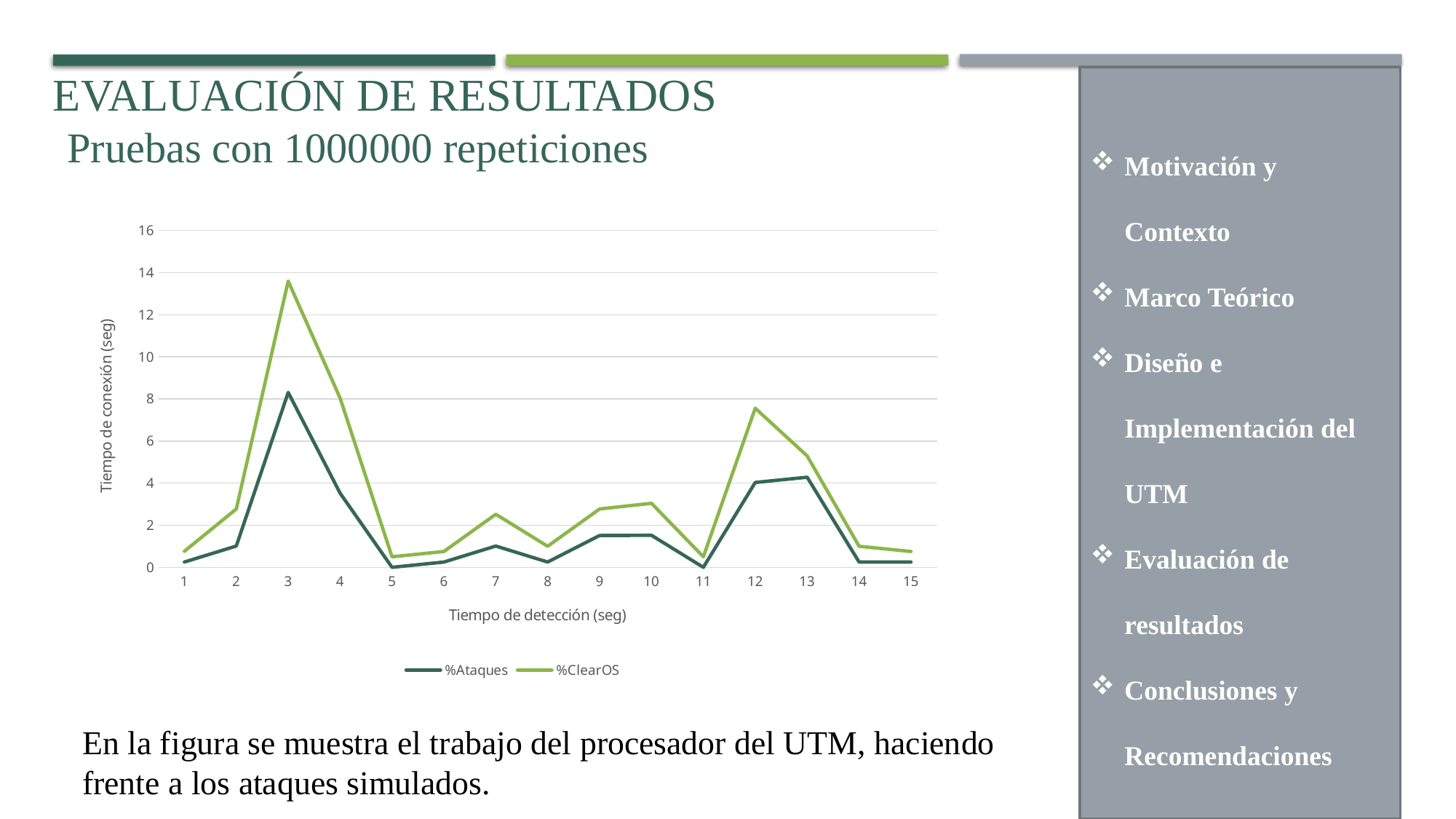
At x = 12, which series has the higher value, %Ataques or %ClearOS? %ClearOS At which x-axis value does the %ClearOS series reach its highest point? 3 At which x-axis value does the %Ataques series reach its highest point? 3 Is the value for %ClearOS at x = 3 greater or less than 12? greater For the %ClearOS series, is the value at x = 7 larger or smaller than the value at x = 8? larger What kind of chart is shown on the slide? line chart How many points are plotted along the x axis for each series? 15 What is the title of the y axis? Tiempo de conexión (seg) Does the %ClearOS series rise or fall between x = 3 and x = 5? fall Is the value for %ClearOS at x = 12 greater or less than 6? greater How many series does the legend list? 2 Is the value for %Ataques at x = 3 greater or less than 6? greater